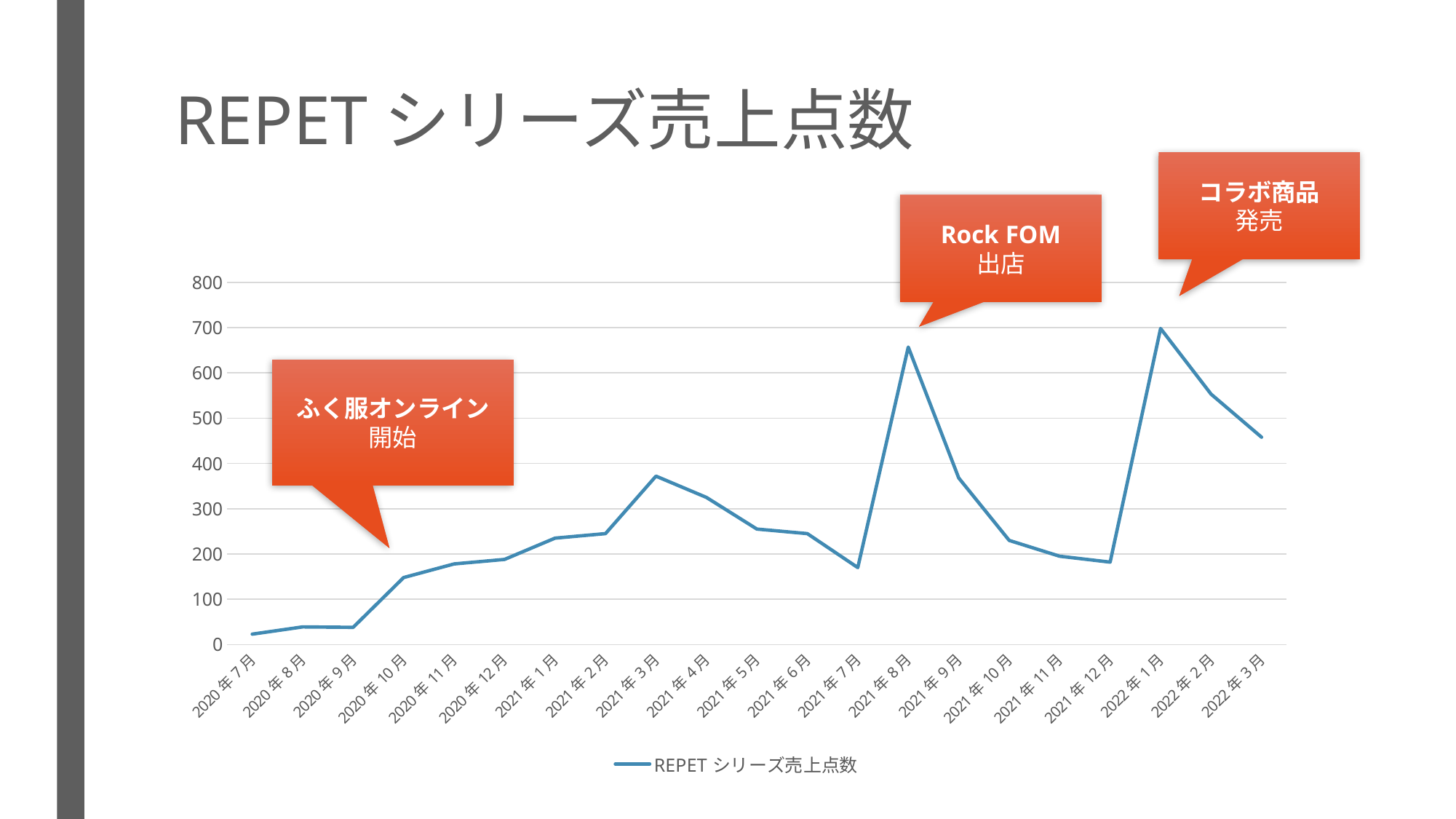
Is the value for 2021年7月 greater or less than 200? less Is the value for 2021年3月 greater or less than 300? greater Which month has the lowest value? 2020年7月 What event does the callout pointing at 2021年8月 label? Rock FOM 出店 How many series does the legend list? 1 Which is larger, the value for 2021年8月 or the value for 2021年3月? 2021年8月 Is the value for 2021年8月 greater or less than 600? greater What is the title of the chart on the slide? REPET シリーズ売上点数 What kind of chart is shown on the slide? Line chart Do the values rise or fall from 2022年1月 to 2022年3月? fall How many months (data points) are plotted along the x axis? 21 Which month has the highest value? 2022年1月